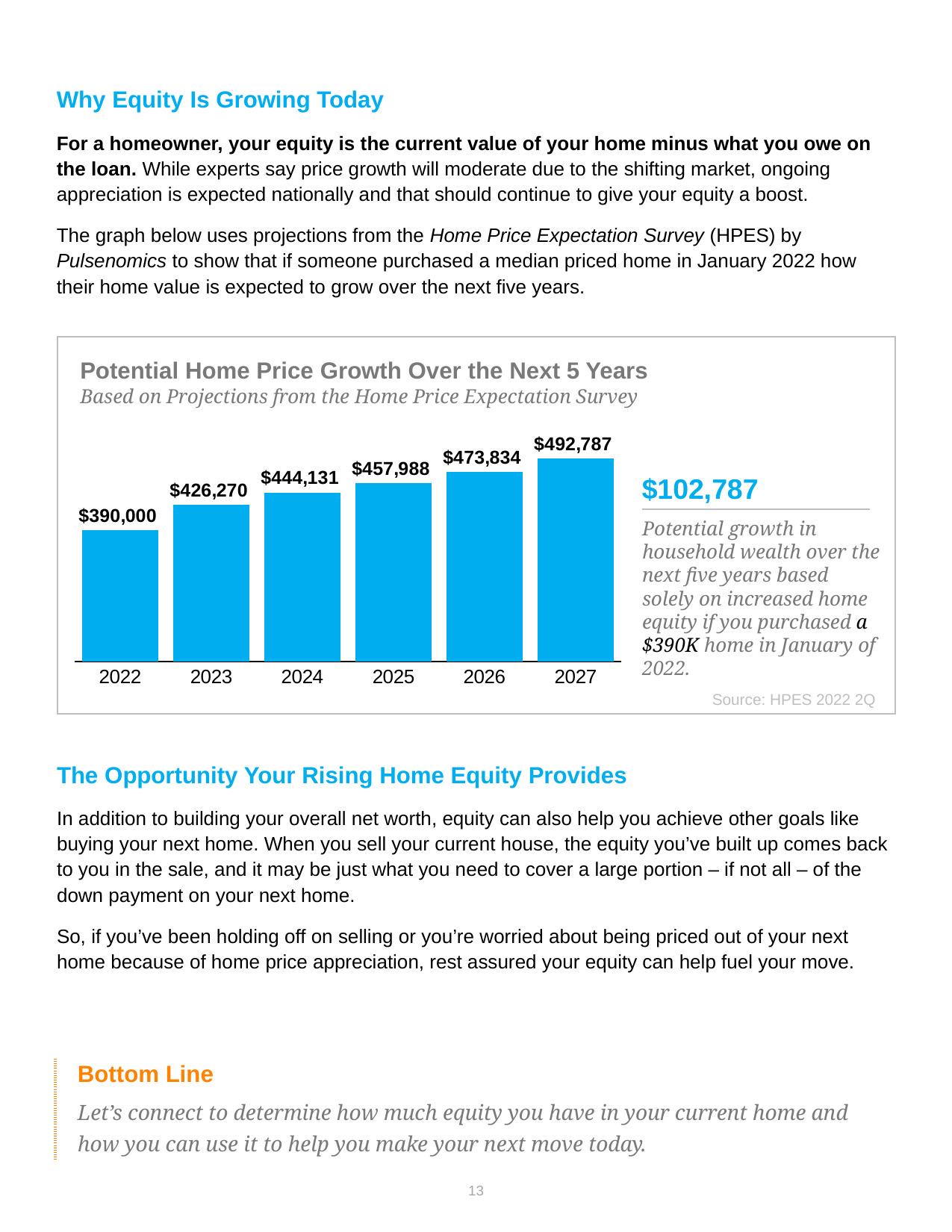
What is the title of the chart? Potential Home Price Growth Over the Next 5 Years Which year has a higher projected home price, 2024 or 2026? 2026 Do the projected home prices rise or fall from 2022 to 2027? Rise What is the difference between the projected home price in 2027 and the price in 2022? $102,787 What is the difference between the projected home prices for 2024 and 2023? $17,861 What is the projected home price for 2027? $492,787 What is the home price shown for 2022? $390,000 What kind of chart is used to show the potential home price growth? Bar chart Which year has the highest projected home price? 2027 What is the projected home price for 2025? $457,988 Which year has the lowest home price on the chart? 2022 How many years are shown on the chart? 6